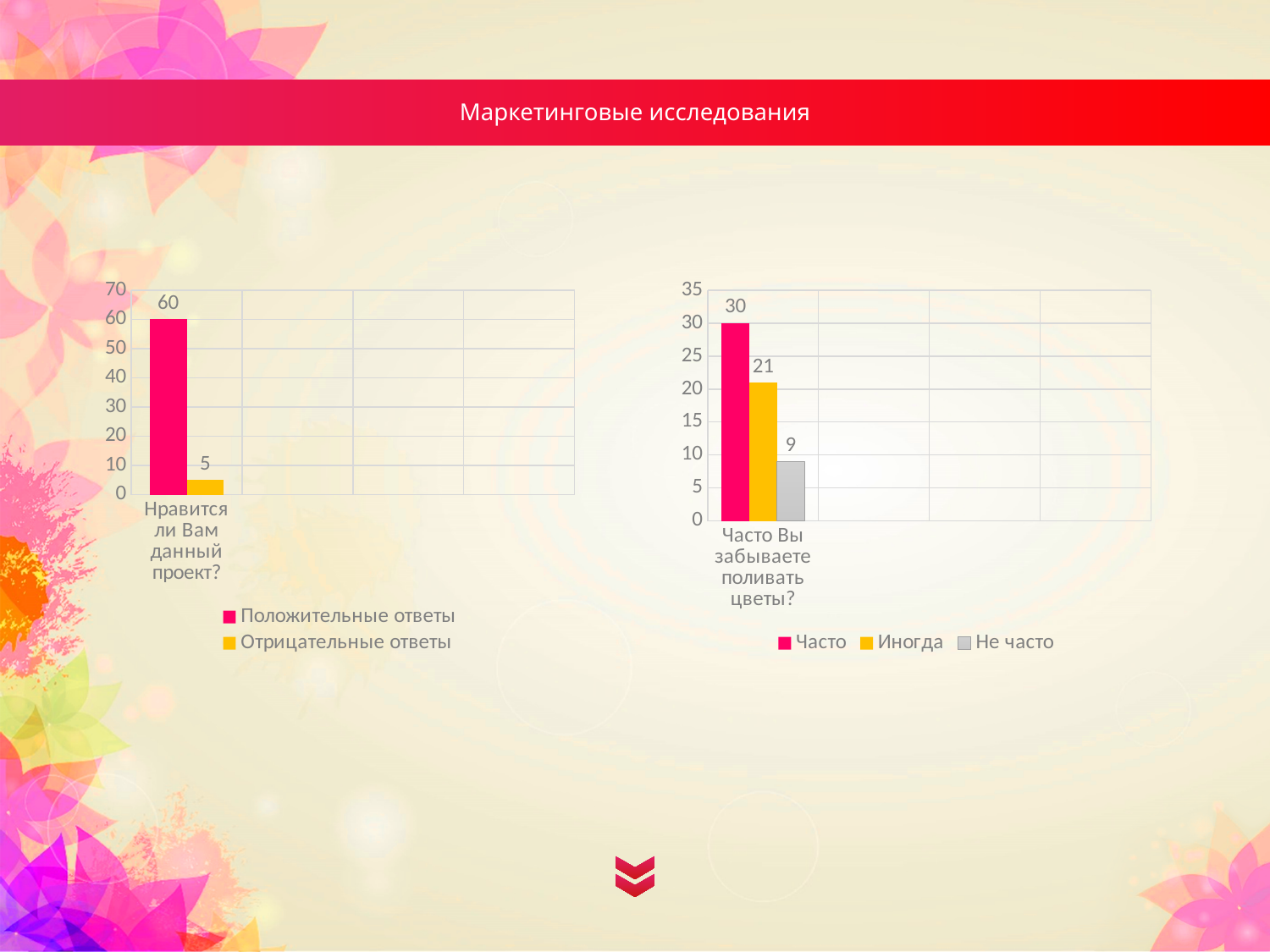
In the right chart ("Часто Вы забываете поливать цветы?"), how many series does the legend list? 3 In the left chart ("Нравится ли Вам данный проект?"), which series has the higher value? Положительные ответы In the right chart ("Часто Вы забываете поливать цветы?"), what is the value for Не часто? 9 In the left chart ("Нравится ли Вам данный проект?"), how many series does the legend list? 2 In the right chart ("Часто Вы забываете поливать цветы?"), what is the difference between Часто and Иногда? 9 In the left chart ("Нравится ли Вам данный проект?"), what is the difference between Положительные ответы and Отрицательные ответы? 55 In the right chart ("Часто Вы забываете поливать цветы?"), what is the value for Часто? 30 What kind of chart is the right chart ("Часто Вы забываете поливать цветы?")? Bar chart In the right chart ("Часто Вы забываете поливать цветы?"), what is the value for Иногда? 21 In the left chart ("Нравится ли Вам данный проект?"), what is the value for Положительные ответы? 60 In the left chart ("Нравится ли Вам данный проект?"), what is the value for Отрицательные ответы? 5 In the right chart ("Часто Вы забываете поливать цветы?"), which series has the lowest value? Не часто